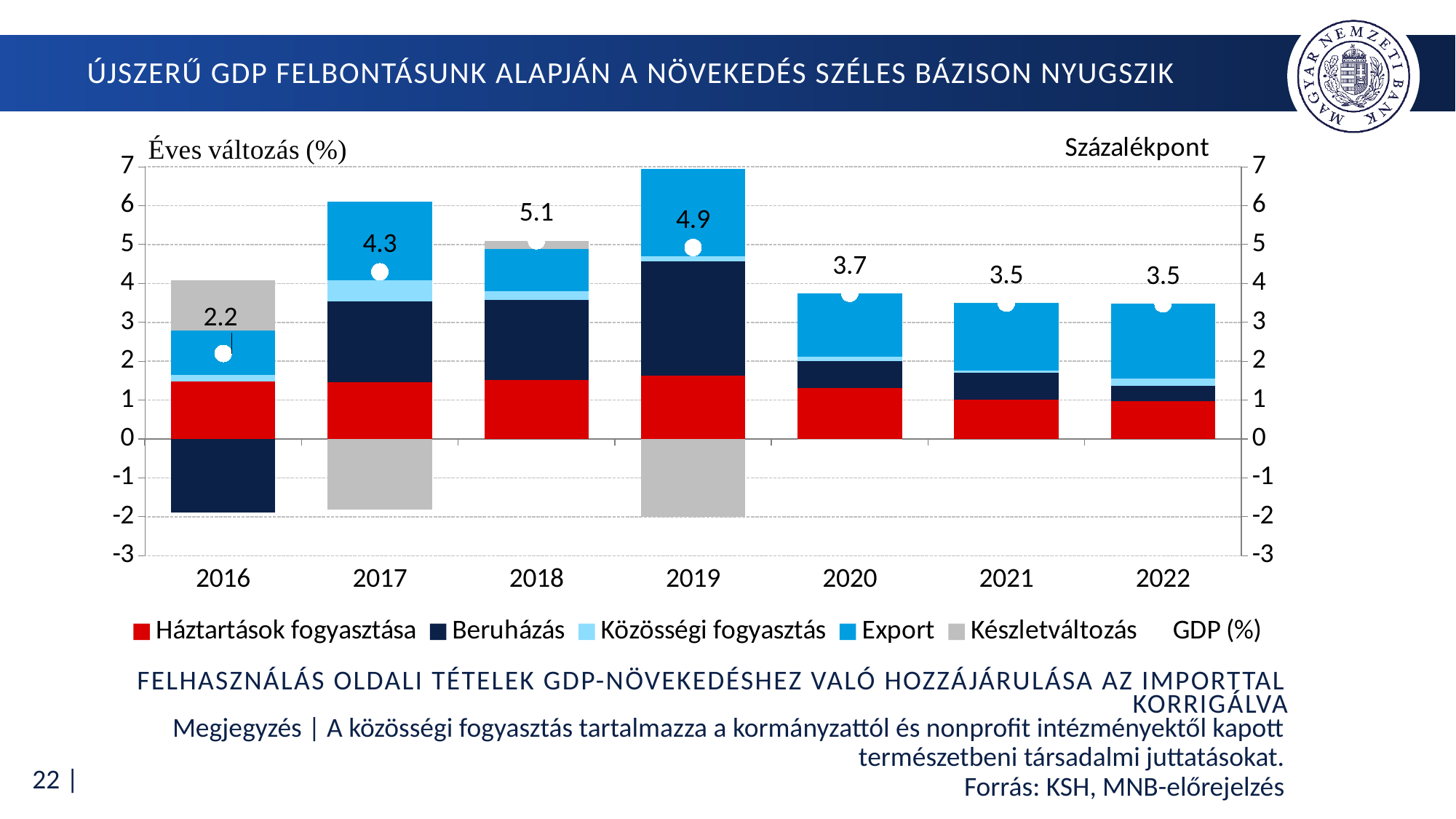
Which year has the larger GDP (%) value, 2017 or 2019? 2019 What kind of chart is shown on the slide? Stacked bar chart combined with GDP (%) plotted as point markers (combination chart) How many years are shown on the x axis? 7 Which year has the lowest GDP (%) value? 2016 What is the GDP (%) value shown for 2016? 2.2 What is the difference between the GDP (%) values for 2018 and 2016? 2.9 What is the GDP (%) value shown for 2018? 5.1 How many entries does the legend list? 6 Does the GDP (%) value rise or fall from 2019 to 2022? fall Is the Készletváltozás contribution in 2019 greater or less than -1? less What is the GDP (%) value shown for 2020? 3.7 Which year has the highest GDP (%) value? 2018